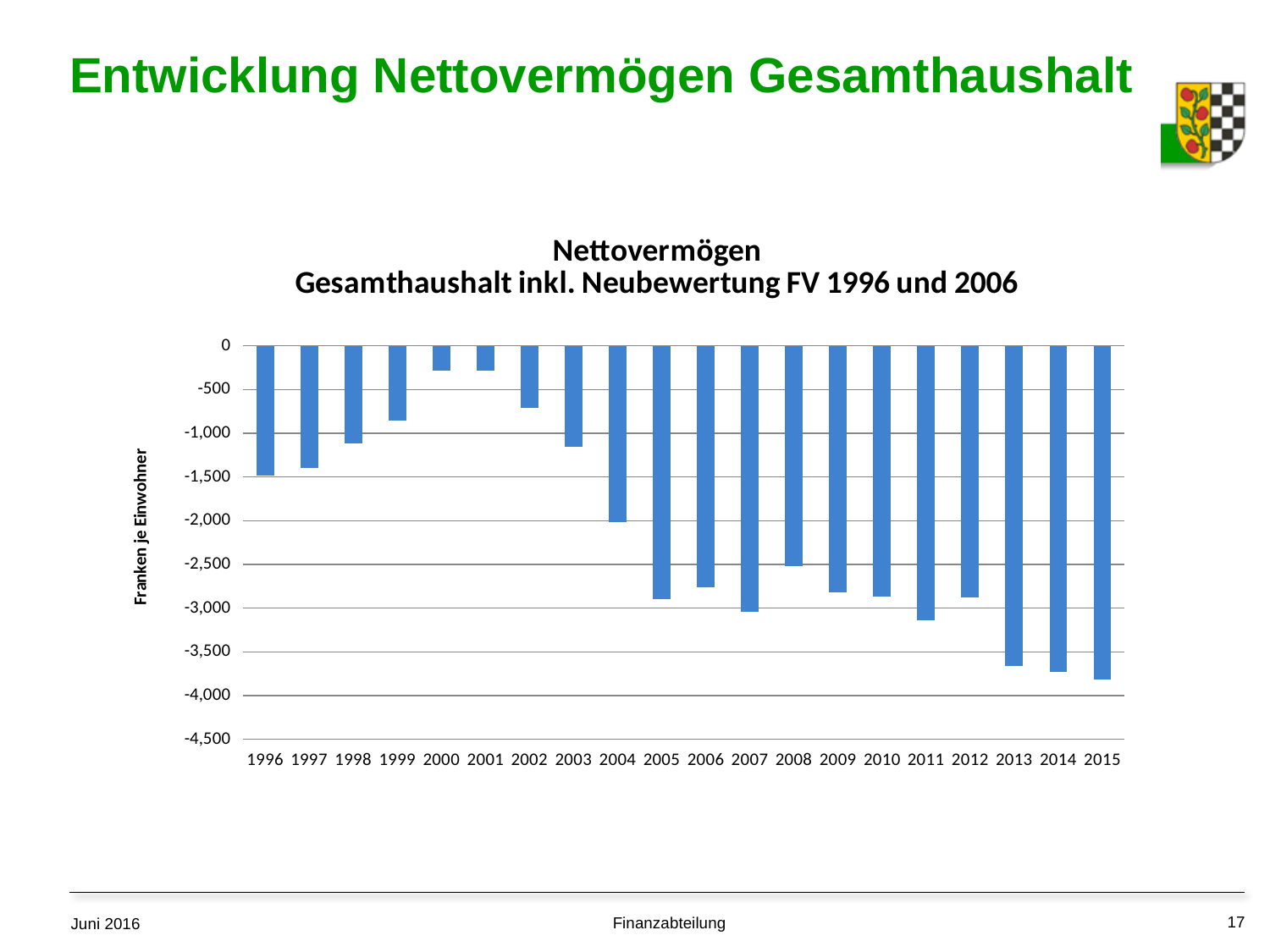
What kind of chart is shown on the slide? Bar chart What is the label of the vertical axis of the chart? Franken je Einwohner What is the title of the chart? Nettovermögen Gesamthaushalt inkl. Neubewertung FV 1996 und 2006 Is the value for 2000 above or below -500 on the axis? above Is the value for 2011 above or below -3,000 on the axis? below How many years are shown on the x axis of the chart? 20 From 1996 to 2000, do the values rise or fall? rise Which year has the lowest (most negative) value in the chart? 2015 Is the value for 1999 above or below -1,000 on the axis? above Which year has the higher value, 2004 or 2013? 2004